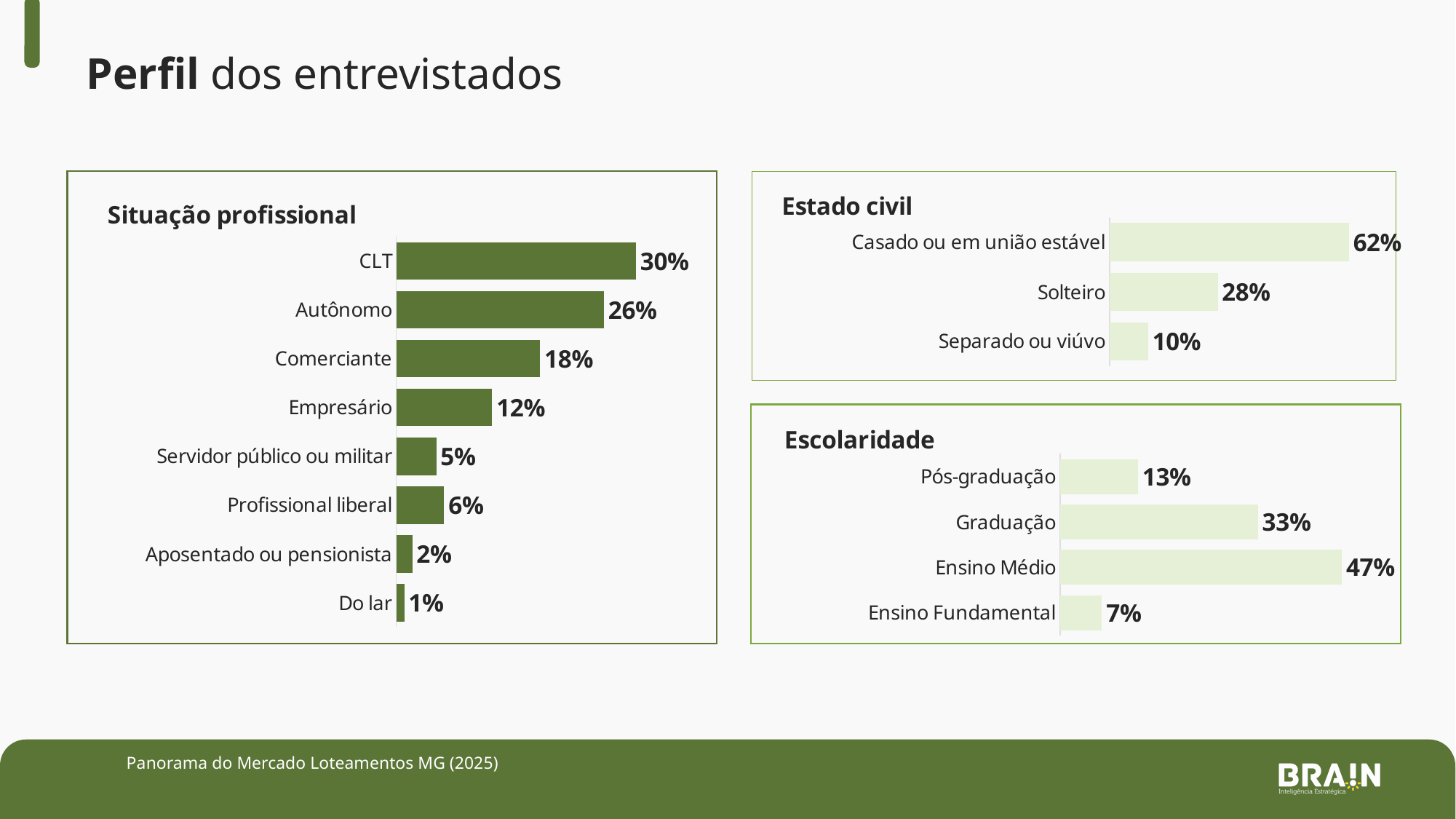
In the 'Situação profissional' chart, what is the value for Autônomo? 26% What type of chart is the 'Escolaridade' chart? Bar chart In the 'Escolaridade' chart, which category has the highest value? Ensino Médio In the 'Situação profissional' chart, how many categories are shown? 8 In the 'Situação profissional' chart, what is the difference between the values for CLT and Comerciante? 12% In the 'Estado civil' chart, what is the value for Solteiro? 28% In the 'Situação profissional' chart, which is larger: Servidor público ou militar or Profissional liberal? Profissional liberal In the 'Situação profissional' chart, which category has the lowest value? Do lar In the 'Estado civil' chart, what is the difference between Casado ou em união estável and Separado ou viúvo? 52% In the 'Situação profissional' chart, which category has the highest value? CLT In the 'Escolaridade' chart, what is the value for Ensino Fundamental? 7% In the 'Estado civil' chart, which category has the highest value? Casado ou em união estável